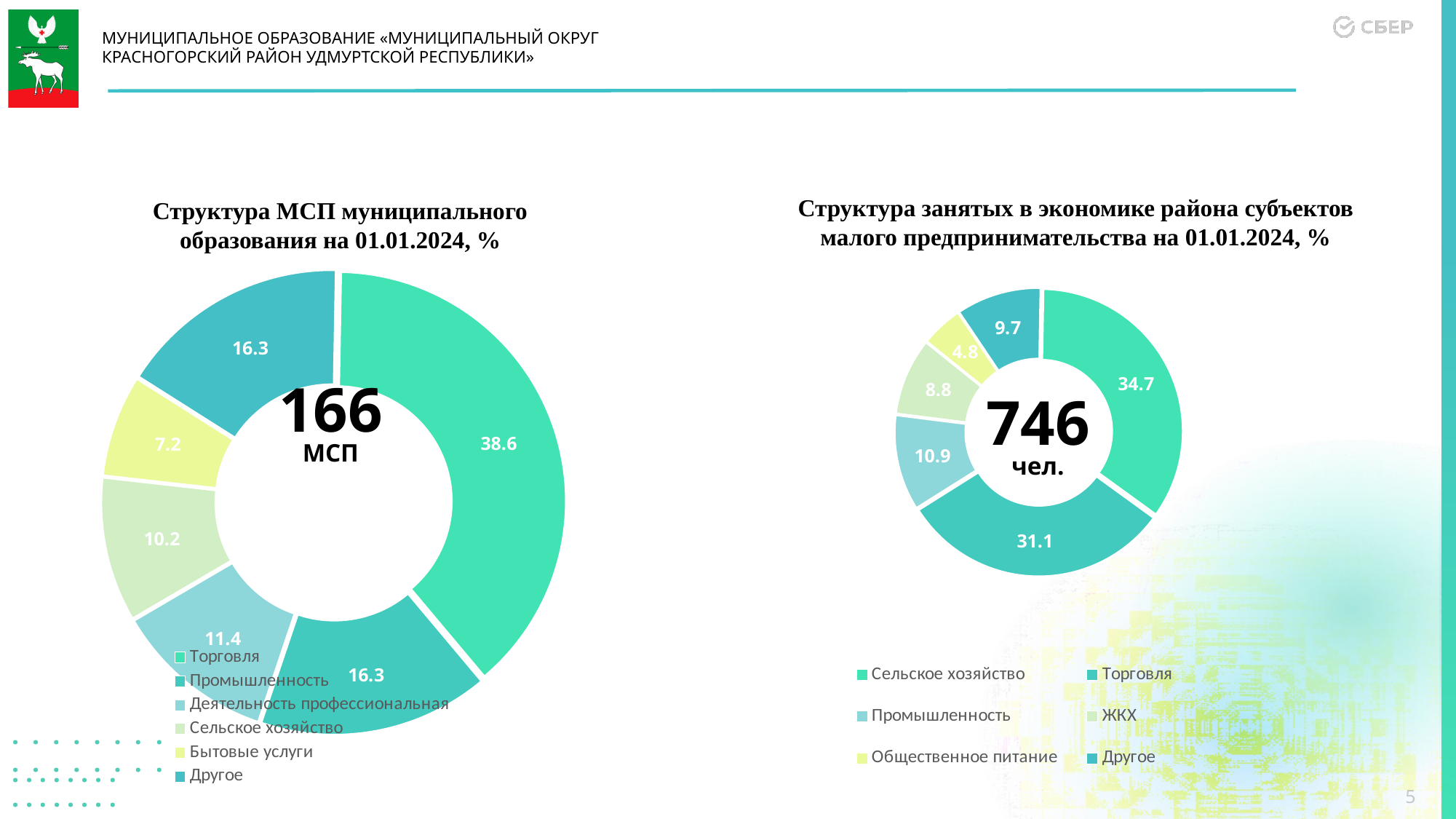
In the left chart (Структура МСП муниципального образования), what number is shown in the centre of the donut? 166 МСП In the left chart (Структура МСП муниципального образования), what is the difference between Торговля and Промышленность? 22.3 In the left chart (Структура МСП муниципального образования), which category has the largest share? Торговля In the right chart (Структура занятых в экономике района), which category has the smallest share? Общественное питание In the right chart (Структура занятых в экономике района), which is larger: Промышленность or Другое? Промышленность In the right chart (Структура занятых в экономике района), what is the value for ЖКХ? 8.8 In the left chart (Структура МСП муниципального образования), what is the value for Торговля? 38.6 What type of chart is used on the right side of the slide (Структура занятых в экономике района)? Pie (donut) chart In the left chart (Структура МСП муниципального образования), which category has the smallest share? Бытовые услуги In the left chart (Структура МСП муниципального образования), what is the value for Бытовые услуги? 7.2 In the right chart (Структура занятых в экономике района), what is the value for Сельское хозяйство? 34.7 In the left chart (Структура МСП муниципального образования), how many categories does the legend list? 6